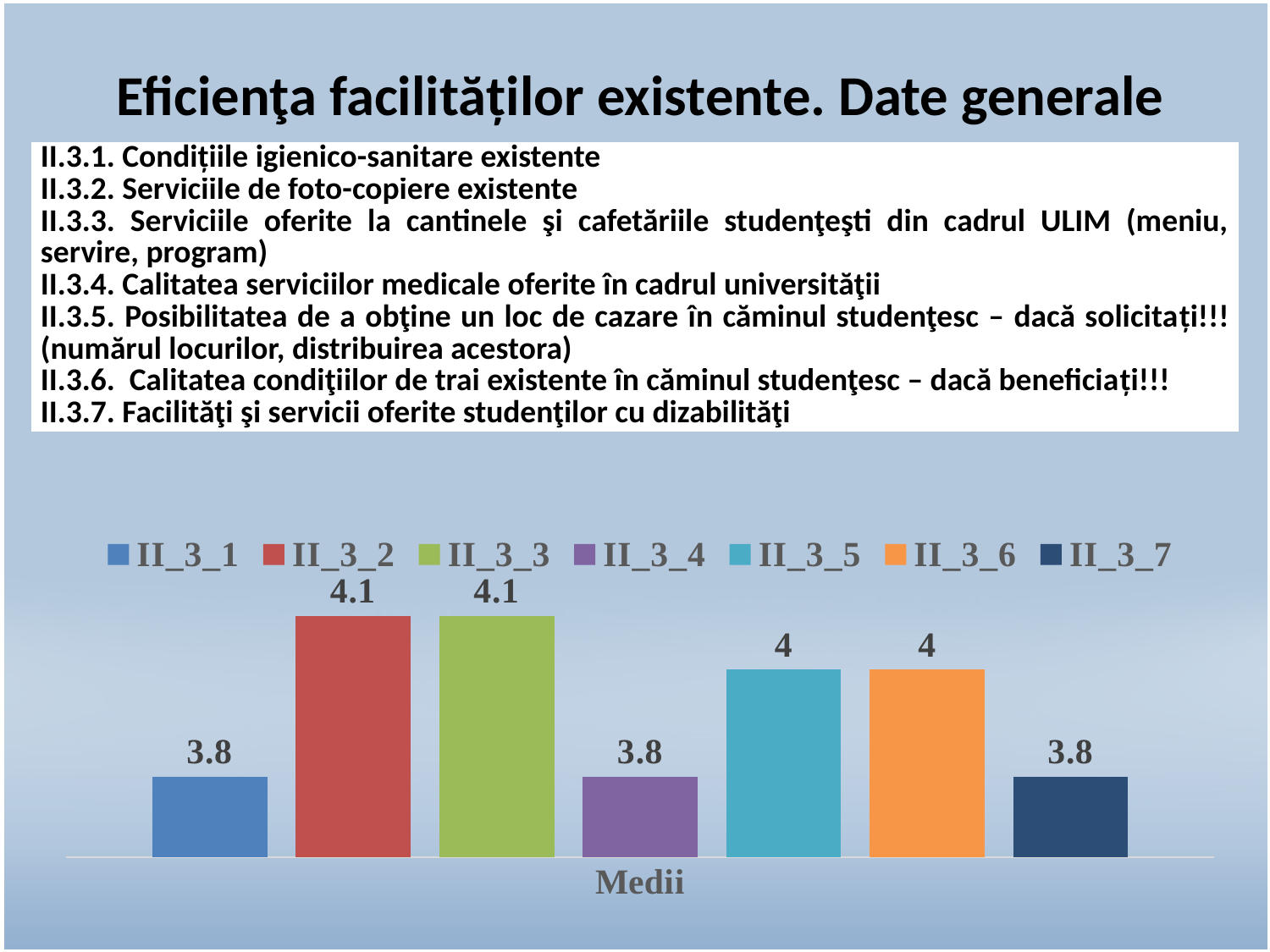
What is the value for II_3_1 in the Medii chart? 3.8 What is the value for II_3_5 in the Medii chart? 4 What is the category label shown on the x axis of the chart? Medii How many series does the legend list? 7 What is the value for II_3_2 in the Medii chart? 4.1 What is the value for II_3_3 in the Medii chart? 4.1 What is the value for II_3_4 in the Medii chart? 3.8 Which has a larger value, II_3_5 or II_3_4? II_3_5 What kind of chart is shown on the slide? Bar chart What is the difference between the values for II_3_2 and II_3_1? 0.3 What is the value for II_3_7 in the Medii chart? 3.8 What is the value for II_3_6 in the Medii chart? 4